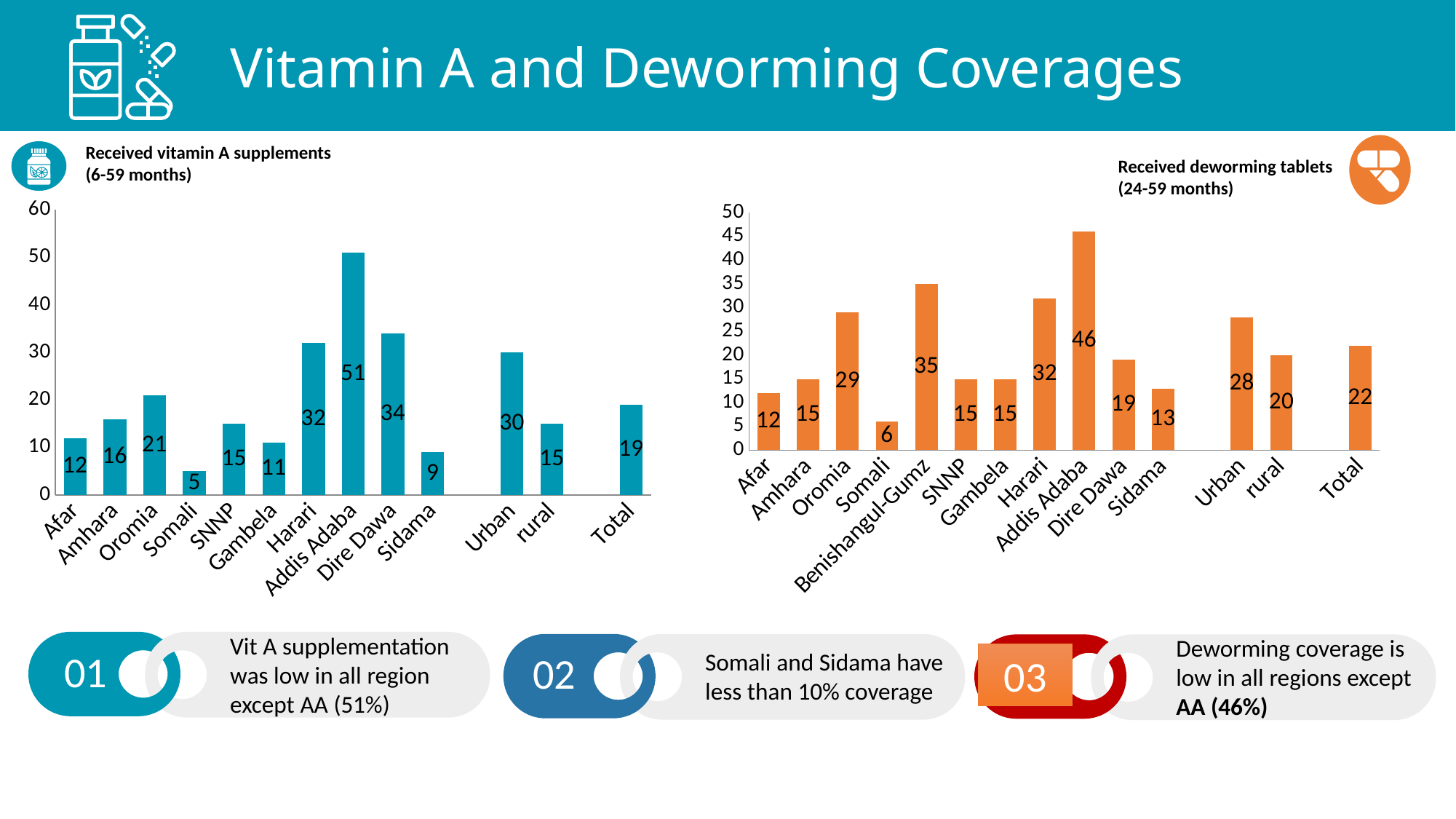
What type of chart is the 'Received vitamin A supplements (6-59 months)' chart? Bar chart How many bars are plotted in the 'Received deworming tablets (24-59 months)' chart? 14 In the 'Received deworming tablets (24-59 months)' chart, what is the difference between the Urban and rural values? 8 How many bars are plotted in the 'Received vitamin A supplements (6-59 months)' chart? 13 In the 'Received deworming tablets (24-59 months)' chart, which category has the highest value? Addis Adaba In the 'Received vitamin A supplements (6-59 months)' chart, is the value for Urban greater or less than 20? greater In the 'Received deworming tablets (24-59 months)' chart, what is the value for Benishangul-Gumz? 35 In the 'Received vitamin A supplements (6-59 months)' chart, what is the value for Addis Adaba? 51 What colour are the bars in the 'Received deworming tablets (24-59 months)' chart? Orange In the 'Received vitamin A supplements (6-59 months)' chart, what is the difference between the values for Dire Dawa and Harari? 2 In the 'Received vitamin A supplements (6-59 months)' chart, which category has the lowest value? Somali In the 'Received deworming tablets (24-59 months)' chart, which is larger, the value for Oromia or the value for Dire Dawa? Oromia